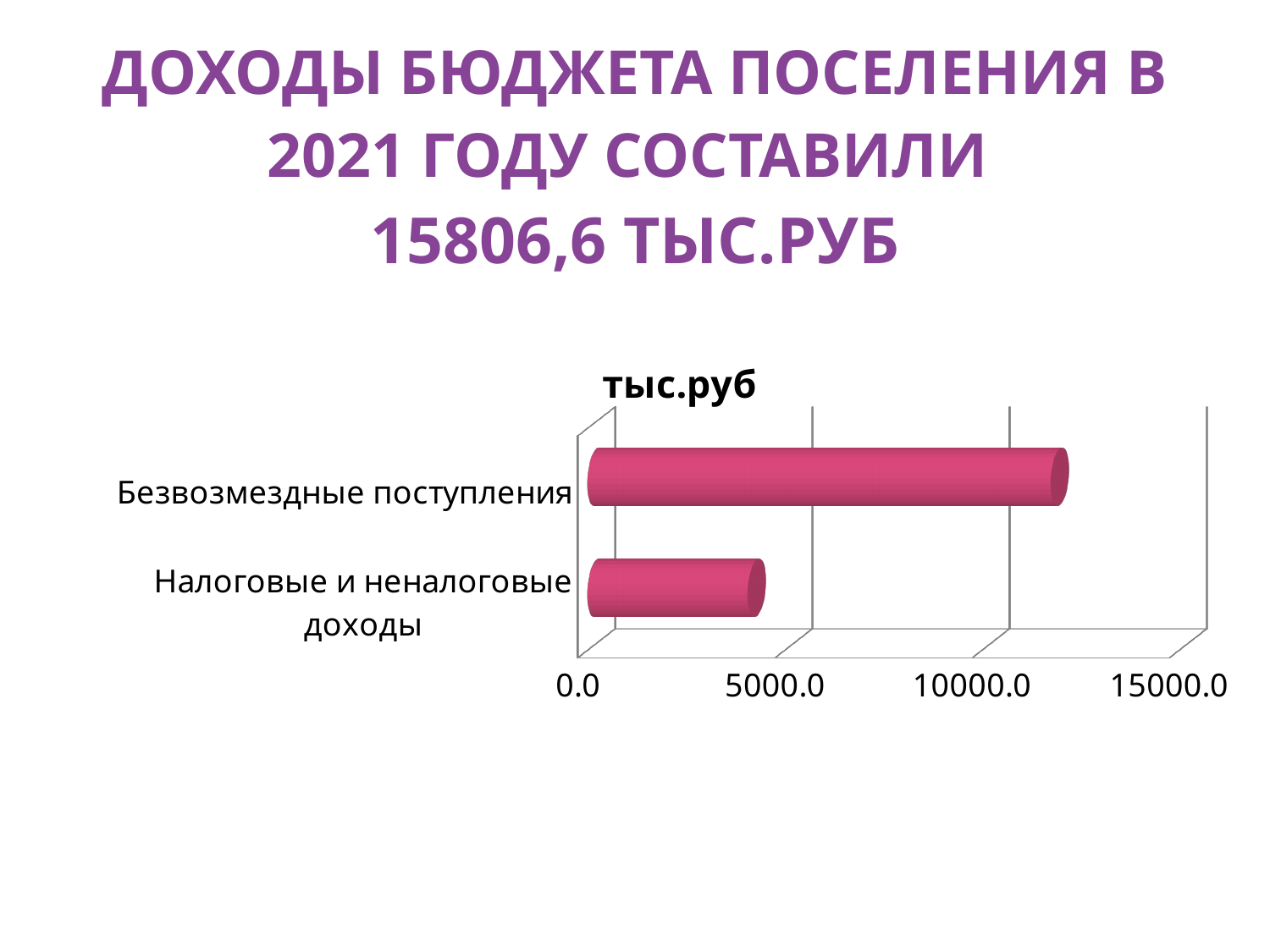
Which category has the lowest value in the chart? Налоговые и неналоговые доходы How many categories are plotted in the chart? 2 Which is larger: the value for Безвозмездные поступления or the value for Налоговые и неналоговые доходы? Безвозмездные поступления Which category has the highest value in the chart? Безвозмездные поступления What is the highest tick value shown on the horizontal axis of the chart? 15000.0 Is the value for Налоговые и неналоговые доходы greater or less than 5000.0? less Is the value for Безвозмездные поступления greater or less than 15000.0? less What is the title of the chart? тыс.руб Is the value for Безвозмездные поступления greater or less than 10000.0? greater What kind of chart is shown on the slide? bar chart